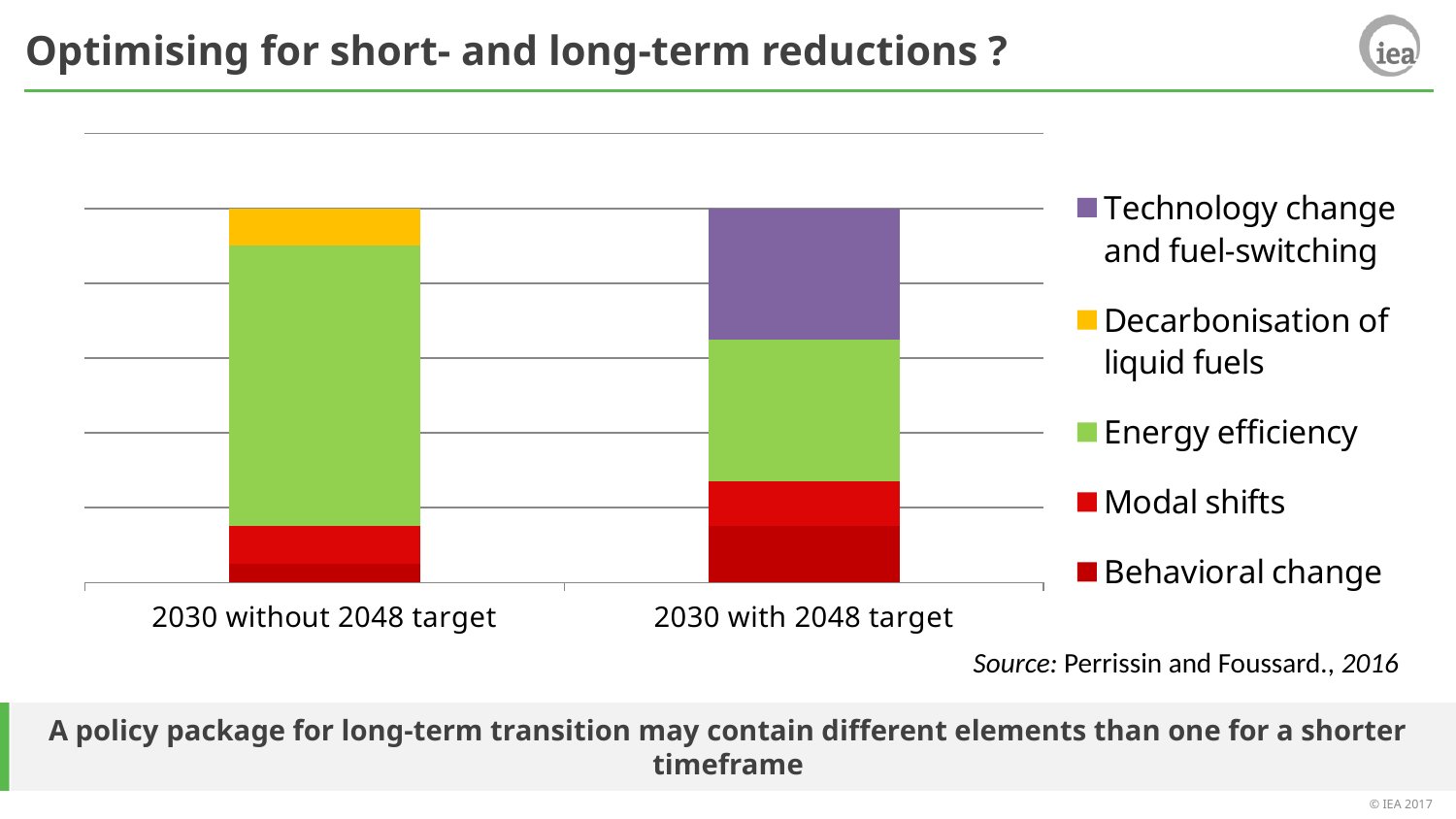
Which series appears only in the '2030 with 2048 target' bar? Technology change and fuel-switching What kind of chart is shown on the slide? Stacked bar chart What are the two category labels on the x axis of the chart? 2030 without 2048 target; 2030 with 2048 target Which bar has the larger Energy efficiency segment, '2030 without 2048 target' or '2030 with 2048 target'? 2030 without 2048 target Which series makes up the smallest share of the '2030 without 2048 target' bar? Behavioral change How many categories are shown on the x axis of the chart? 2 Which series makes up the largest share of the '2030 without 2048 target' bar? Energy efficiency Which series appears only in the '2030 without 2048 target' bar? Decarbonisation of liquid fuels Which bar has the larger Behavioral change segment, '2030 without 2048 target' or '2030 with 2048 target'? 2030 with 2048 target Which series makes up the largest share of the '2030 with 2048 target' bar? Energy efficiency How many series does the chart's legend list? 5